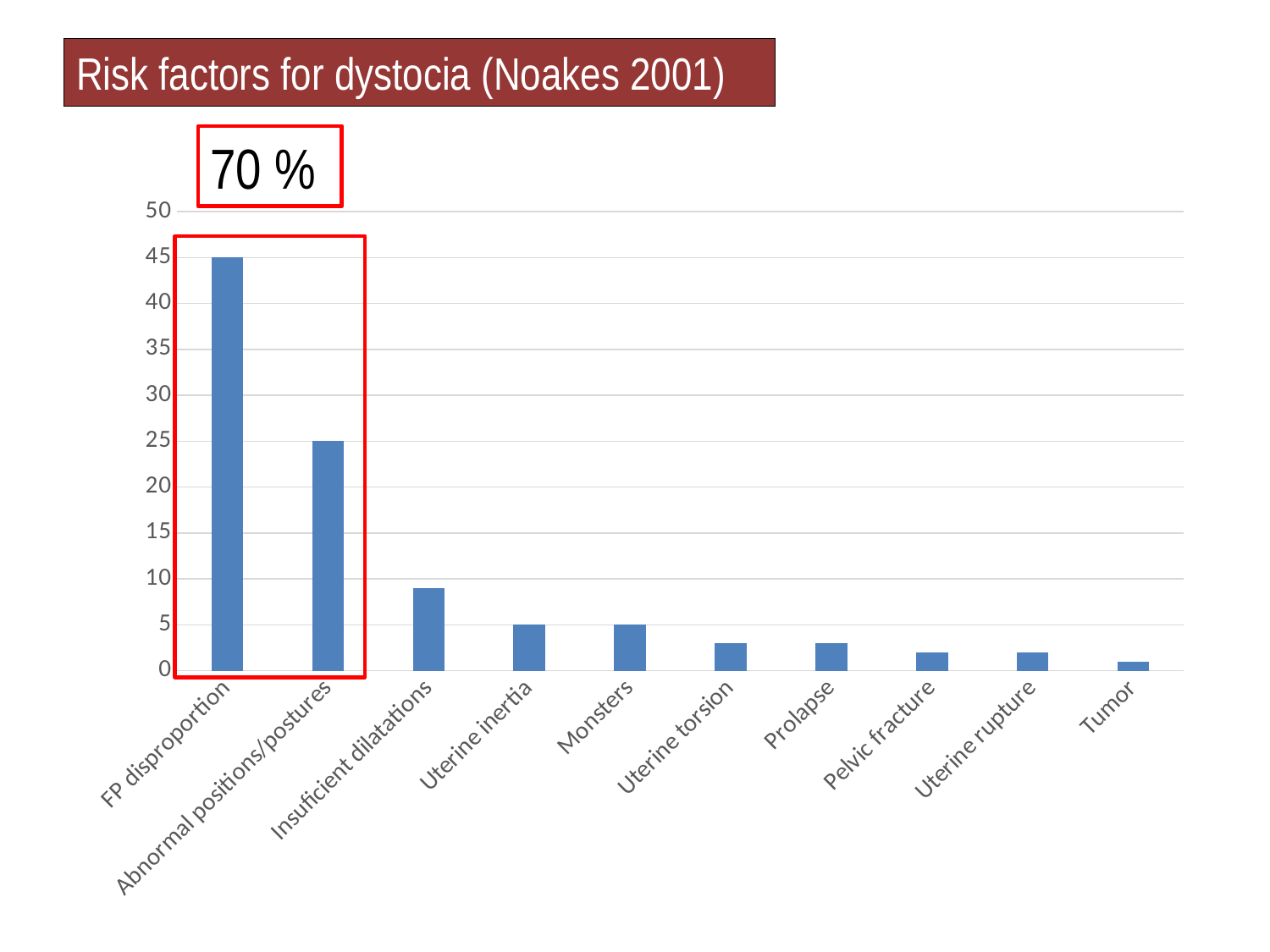
Do the values rise or fall moving left to right along the x axis? fall Which category has the lowest value in the chart? Tumor What is the difference between the values for FP disproportion and Abnormal positions/postures? 20 What is the value for FP disproportion? 45 What is the title of the slide containing the chart? Risk factors for dystocia (Noakes 2001) What kind of chart is shown on the slide? bar chart What is the value for Uterine inertia? 5 Which category has the highest value in the chart? FP disproportion How many categories are plotted on the x axis of the chart? 10 Is the value for Insufficient dilatations greater or less than 10? less Which is larger, the value for Abnormal positions/postures or the value for Insufficient dilatations? Abnormal positions/postures What is the value for Abnormal positions/postures? 25